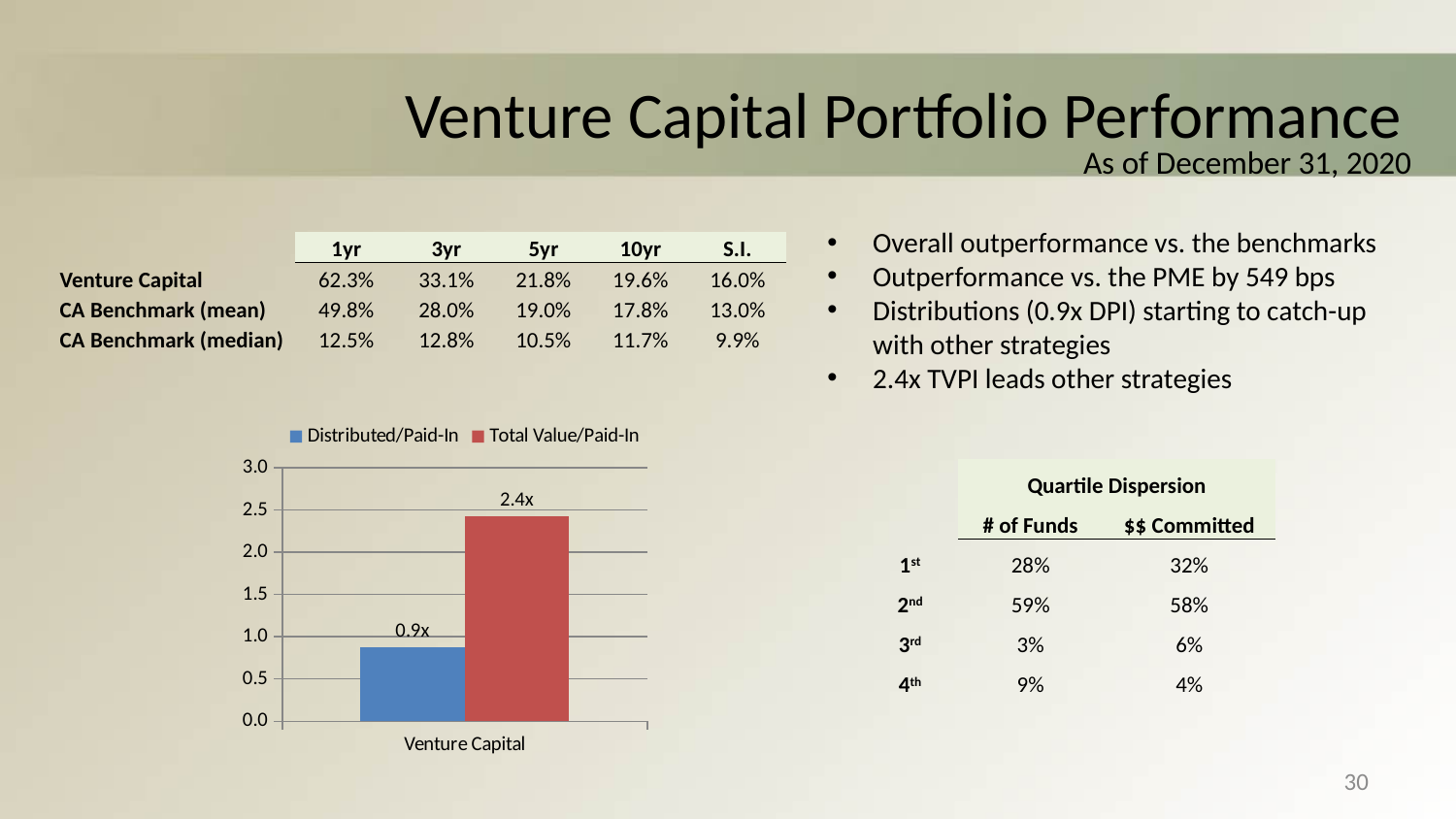
Which series has the higher value in the bar chart, Distributed/Paid-In or Total Value/Paid-In? Total Value/Paid-In What is the Distributed/Paid-In value for Venture Capital in the bar chart? 0.9x What is the category label on the x axis of the bar chart? Venture Capital What is the Total Value/Paid-In value for Venture Capital in the bar chart? 2.4x How many series does the legend of the bar chart list? 2 What is the difference between the Total Value/Paid-In and Distributed/Paid-In values in the bar chart? 1.5x Is the Distributed/Paid-In value in the bar chart greater or less than 1.0? less What colour is the Total Value/Paid-In bar in the chart? Red Is the Total Value/Paid-In value in the bar chart greater or less than 2.0? greater Which series has the lowest value in the bar chart? Distributed/Paid-In How many categories are shown on the x axis of the bar chart? 1 What type of chart is shown on the slide? Bar chart